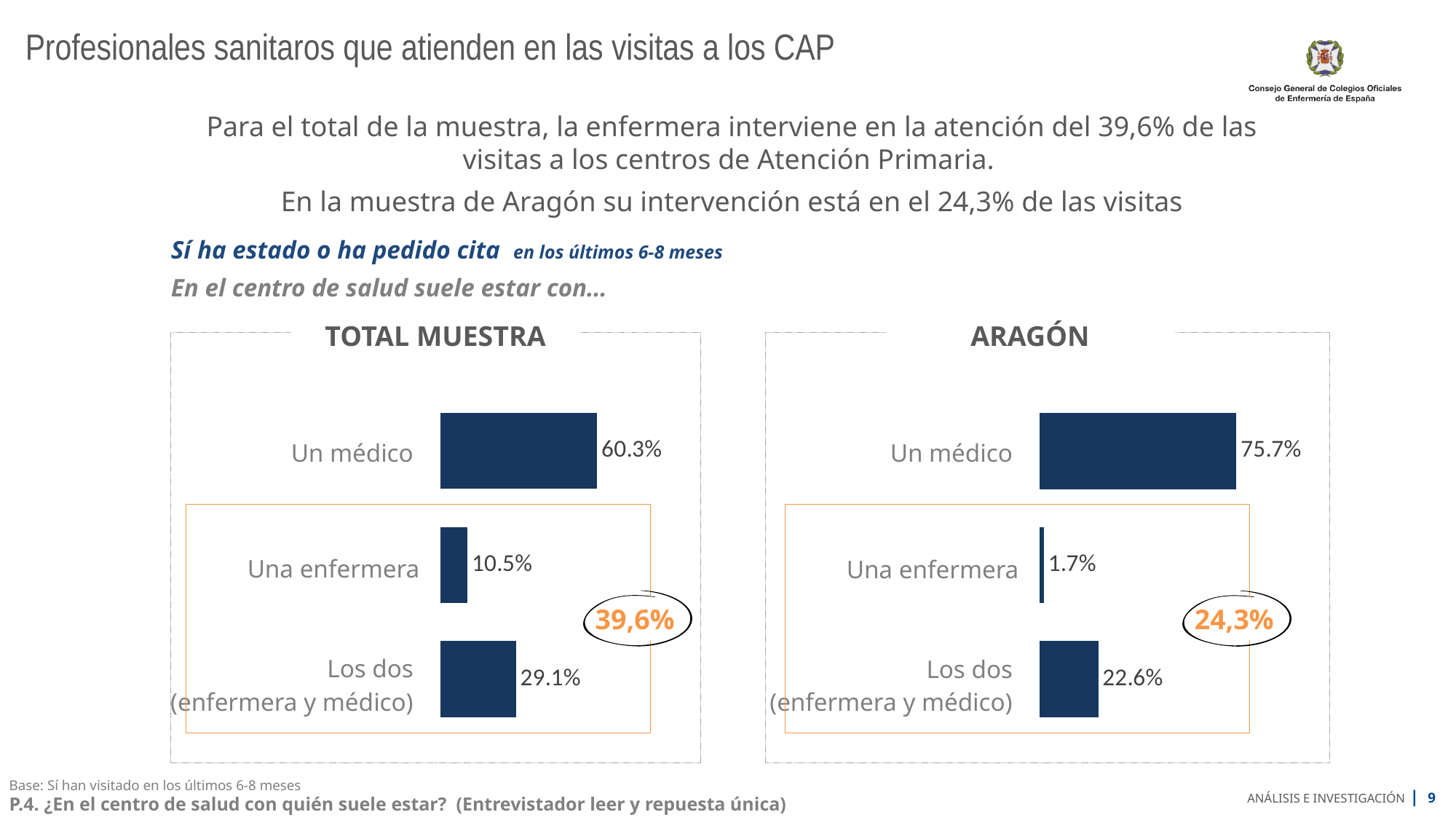
Which is larger: Una enfermera in the TOTAL MUESTRA chart or Una enfermera in the ARAGÓN chart? TOTAL MUESTRA In the TOTAL MUESTRA chart, how many categories are shown? 3 In the ARAGÓN chart, what is the value for Los dos (enfermera y médico)? 22.6% In the TOTAL MUESTRA chart, what is the difference between Un médico and Los dos (enfermera y médico)? 31.2% What kind of chart is the ARAGÓN chart? Bar chart In the ARAGÓN chart, which category has the lowest value? Una enfermera In the TOTAL MUESTRA chart, which category has the highest value? Un médico What is the title of the chart on the right side of the slide? ARAGÓN In the ARAGÓN chart, what is the value for Una enfermera? 1.7% In the TOTAL MUESTRA chart, what is the value for Un médico? 60.3% In the ARAGÓN chart, what is the difference between Un médico and Una enfermera? 74.0% In the TOTAL MUESTRA chart, what is the combined value of Una enfermera and Los dos (enfermera y médico)? 39.6%